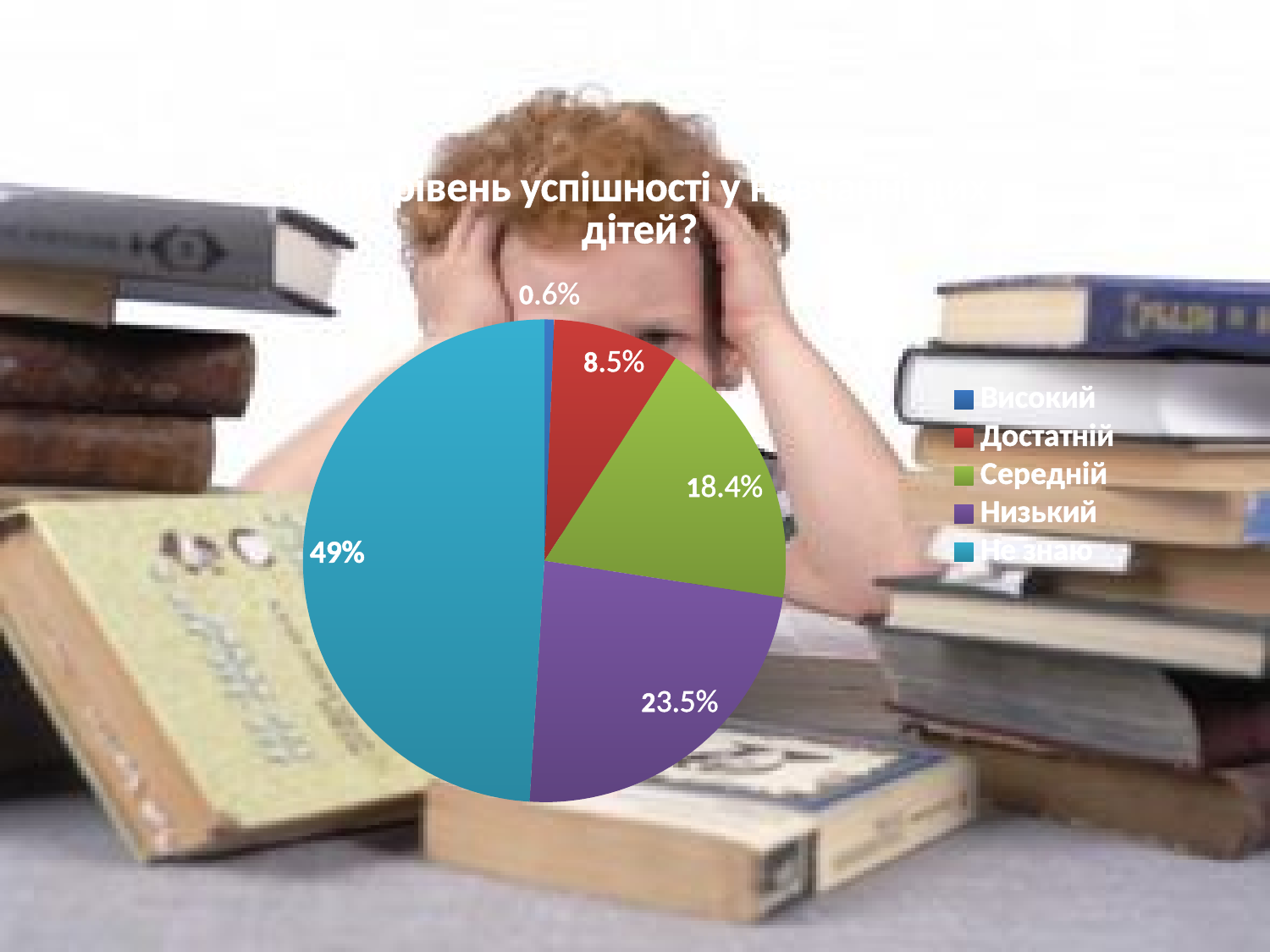
How many categories does the legend list? 5 Which is larger, the "Достатній" slice or the "Середній" slice? Середній What colour is the "Низький" slice? purple What percentage is shown for the "Середній" slice? 18.4% What kind of chart is shown on the slide? pie chart Which category has the largest slice of the pie? Не знаю What percentage is shown for the "Високий" slice? 0.6% What percentage is shown for the "Достатній" slice? 8.5% What percentage is shown for the "Не знаю" slice? 49% What is the difference in percentage points between the "Низький" and "Середній" slices? 5.1 What percentage is shown for the "Низький" slice? 23.5% Which category has the smallest slice of the pie? Високий